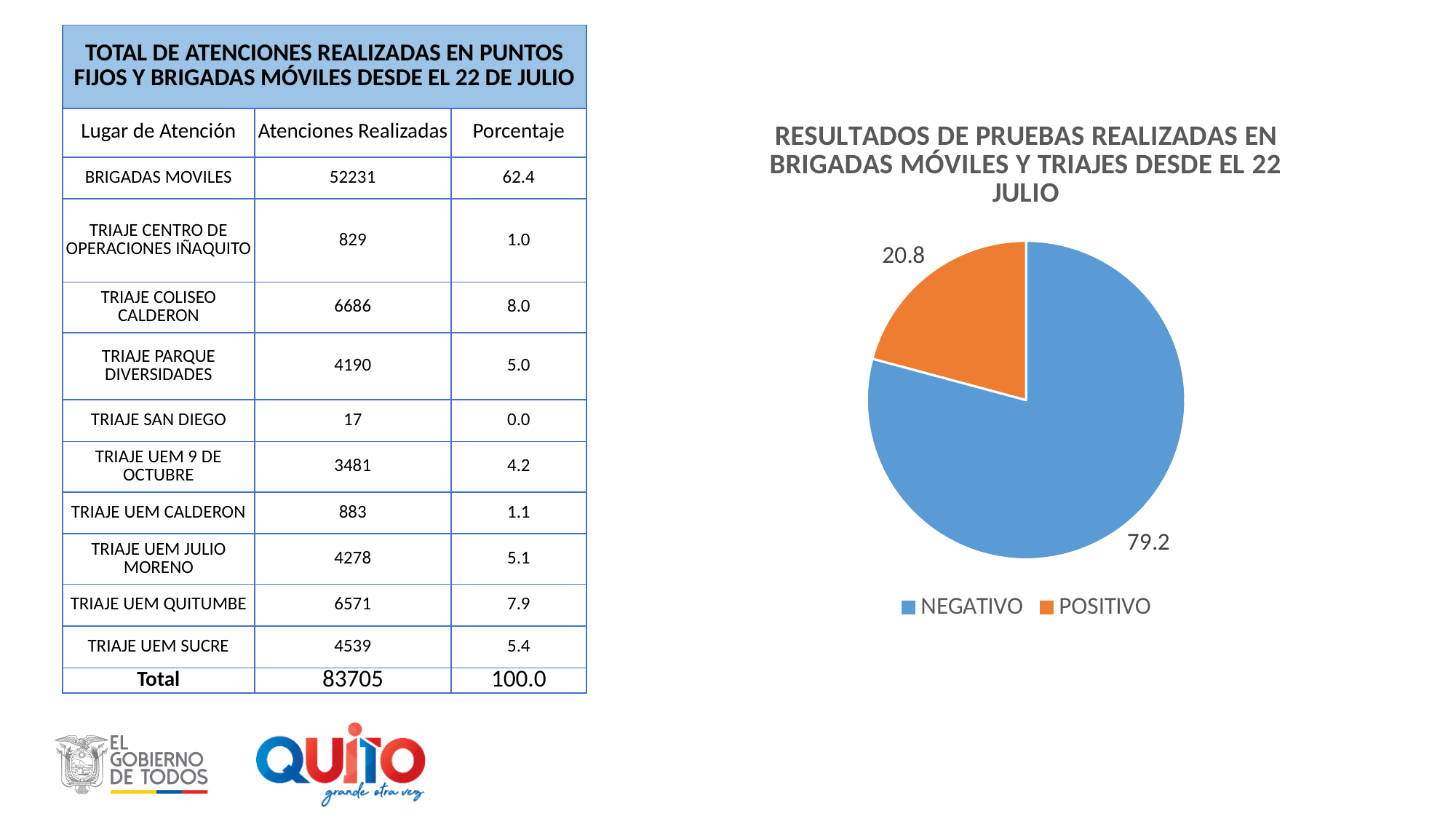
How many slices does the pie chart have? 2 How many entries does the pie chart's legend list? 2 In the pie chart, what is the difference between the NEGATIVO and POSITIVO values? 58.4 In the pie chart, which colour represents POSITIVO? orange In the pie chart, what is the value for NEGATIVO? 79.2 In the pie chart, which is larger, NEGATIVO or POSITIVO? NEGATIVO Which slice of the pie chart is the smallest? POSITIVO What is the title of the pie chart? RESULTADOS DE PRUEBAS REALIZADAS EN BRIGADAS MÓVILES Y TRIAJES DESDE EL 22 JULIO Which slice of the pie chart is the largest? NEGATIVO In the pie chart, what is the value for POSITIVO? 20.8 What kind of chart is shown on the right side of the slide? pie chart